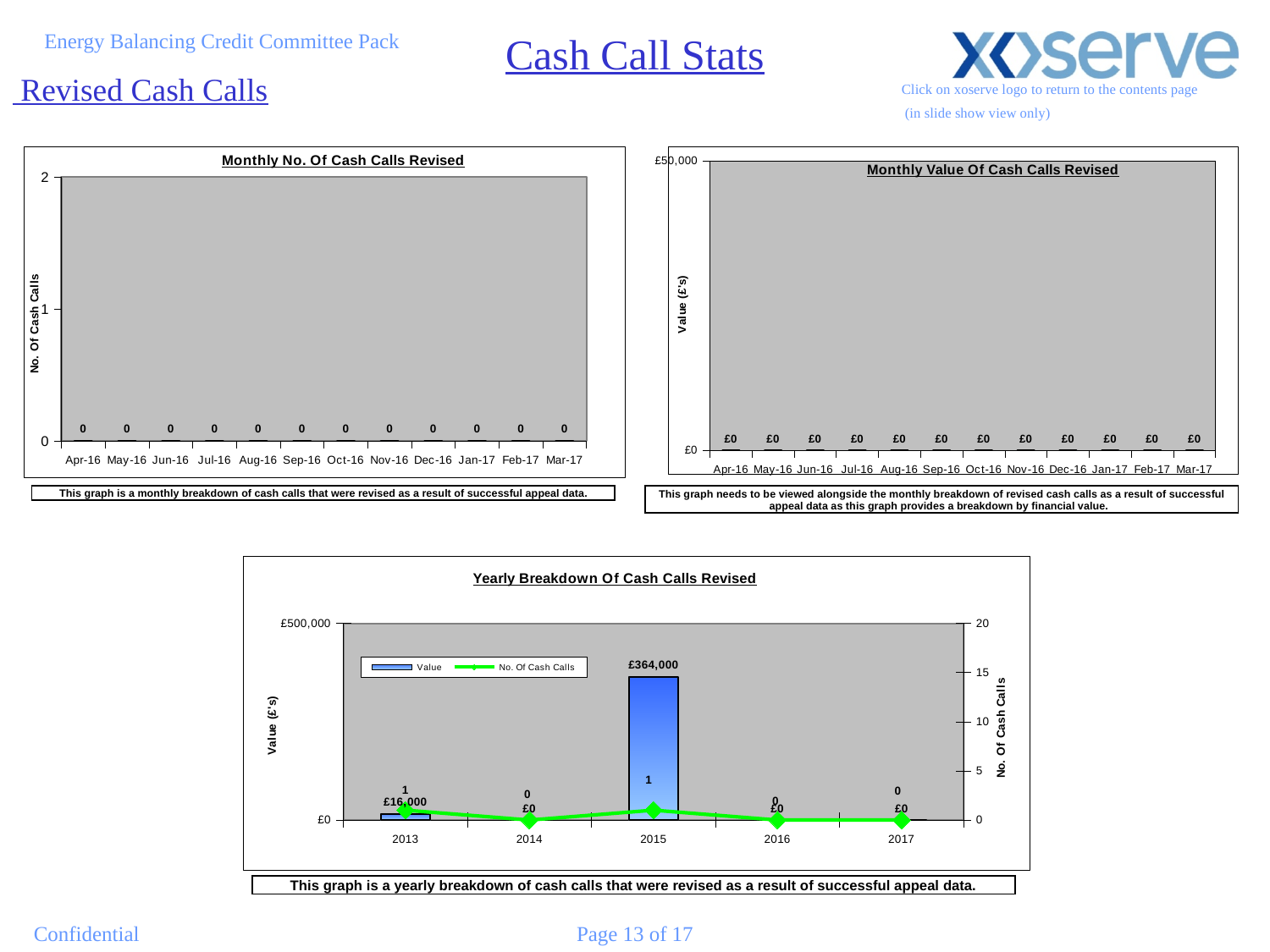
In the 'Monthly Value Of Cash Calls Revised' chart, what is the value for Dec-16? £0 How many months are shown on the x axis of the 'Monthly No. Of Cash Calls Revised' chart? 12 In the 'Yearly Breakdown Of Cash Calls Revised' chart, what is the Value for 2013? £16,000 In the 'Yearly Breakdown Of Cash Calls Revised' chart, what is the Value for 2015? £364,000 In the 'Yearly Breakdown Of Cash Calls Revised' chart, how many series does the legend list? 2 In the 'Yearly Breakdown Of Cash Calls Revised' chart, what is the No. Of Cash Calls for 2015? 1 What kind of chart is the 'Monthly Value Of Cash Calls Revised' chart? Bar chart In the 'Yearly Breakdown Of Cash Calls Revised' chart, what is the difference in Value between 2015 and 2013? £348,000 In the 'Yearly Breakdown Of Cash Calls Revised' chart, which year has the highest Value? 2015 In the 'Yearly Breakdown Of Cash Calls Revised' chart, which is larger, the Value for 2013 or the Value for 2016? 2013 In the 'Monthly No. Of Cash Calls Revised' chart, what is the value for Jul-16? 0 In the 'Yearly Breakdown Of Cash Calls Revised' chart, how many years are shown on the x axis? 5